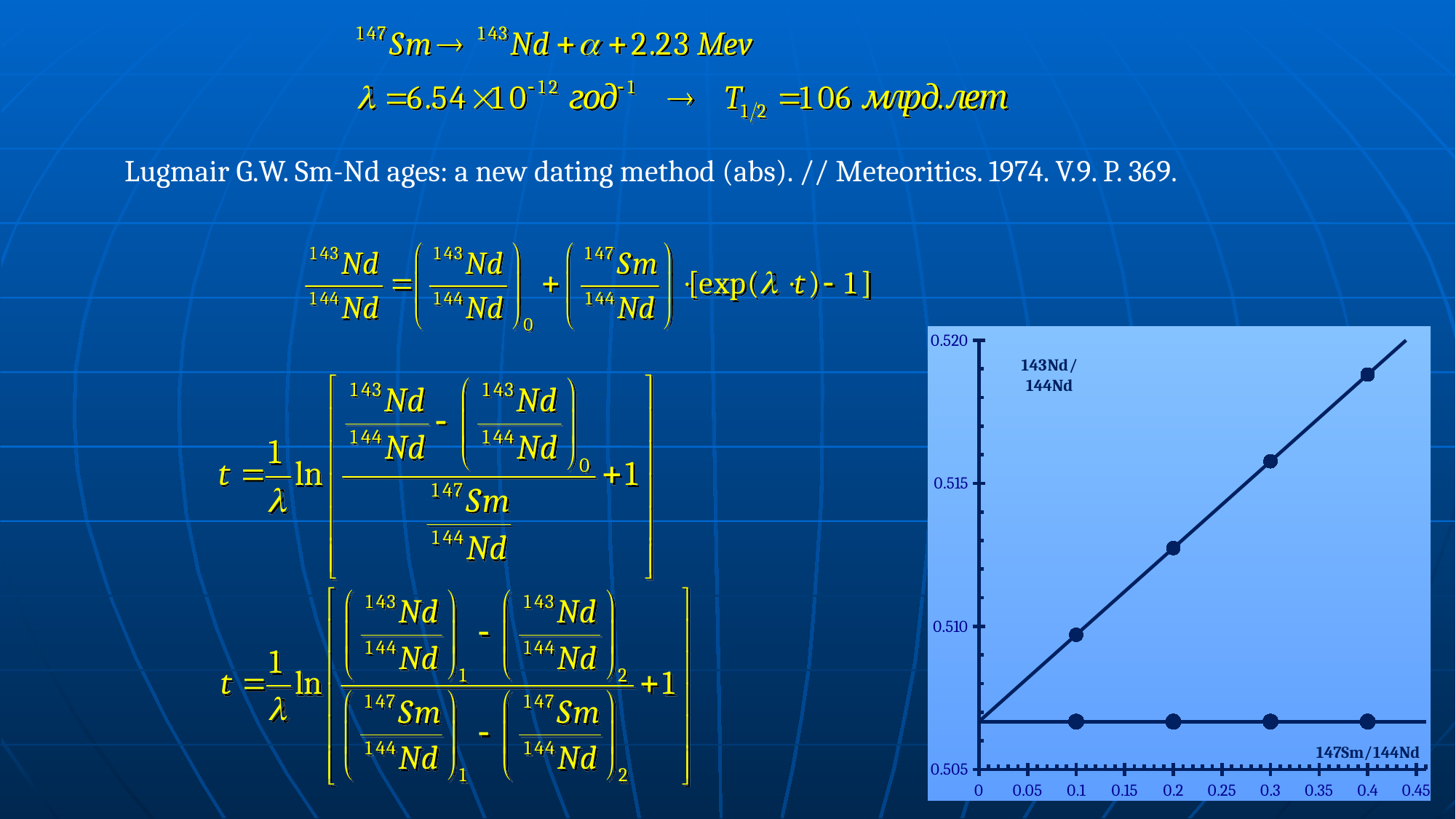
Is the value of the rising line at 147Sm/144Nd = 0.4 greater or less than 0.515? greater What kind of chart is shown on the right side of the slide? line chart How many plotted points lie on the rising line? 4 What is the label of the x axis of the chart? 147Sm/144Nd Do the values of the rising line increase or decrease as 147Sm/144Nd increases? increase Is the value of the horizontal line greater or less than 0.510? less How many plotted points lie on the horizontal line? 4 What is the highest tick value shown on the y axis of the chart? 0.520 At 147Sm/144Nd = 0.2, which line has the larger 143Nd/144Nd value, the rising line or the horizontal line? the rising line Is the value of the rising line at 147Sm/144Nd = 0.3 greater or less than 0.515? greater What is the label of the y axis of the chart? 143Nd/144Nd